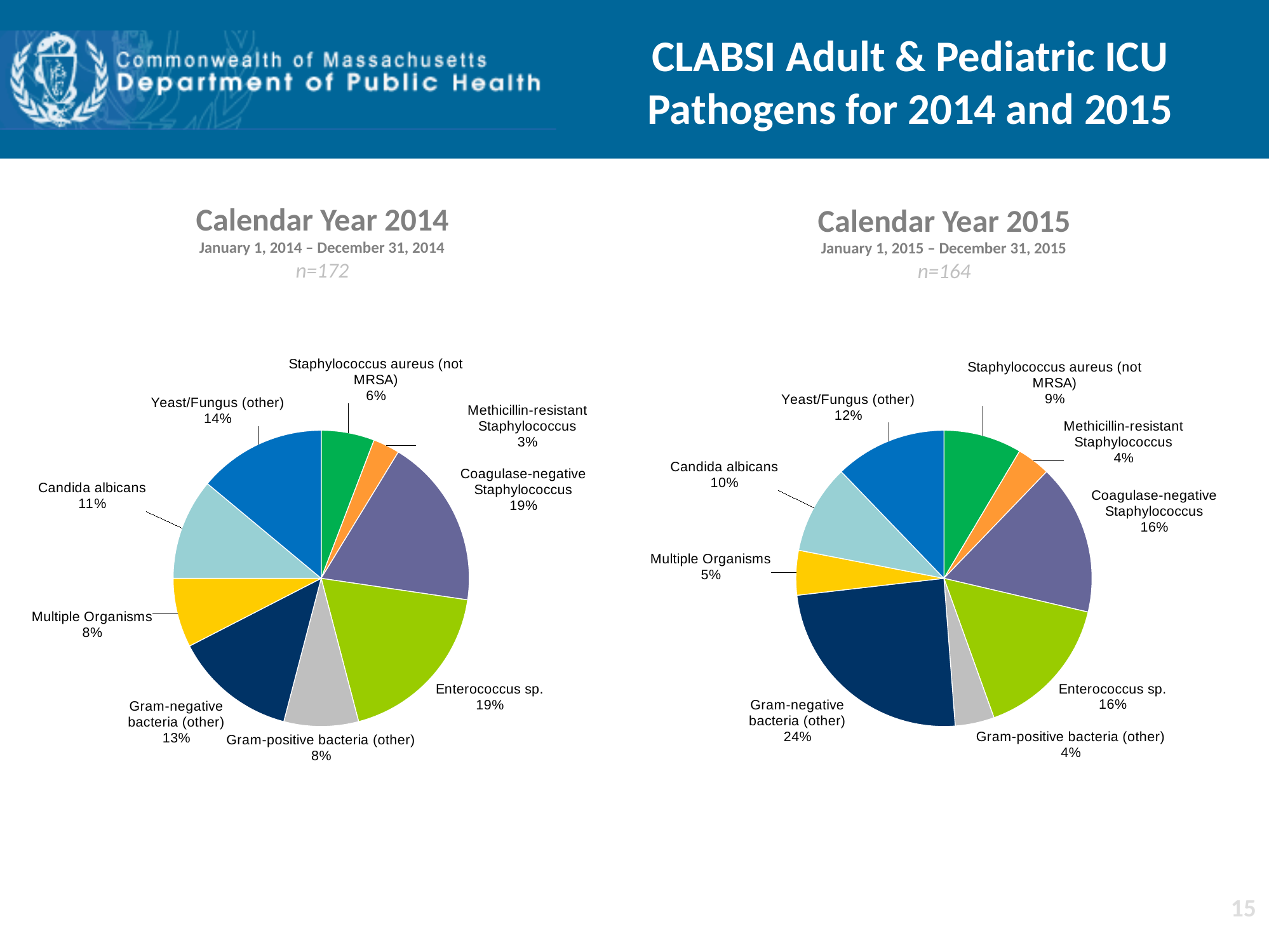
In the Calendar Year 2015 chart, what share is Gram-negative bacteria (other)? 24% How many pathogen categories are shown in the Calendar Year 2014 chart? 9 In the Calendar Year 2014 chart, what is the difference in percentage points between Gram-negative bacteria (other) and Gram-positive bacteria (other)? 5 In the Calendar Year 2015 chart, what is the difference in percentage points between Gram-negative bacteria (other) and Enterococcus sp.? 8 What is the n value shown under the Calendar Year 2015 chart title? n=164 In the Calendar Year 2014 chart, which is larger: Candida albicans or Multiple Organisms? Candida albicans What type of chart is used for Calendar Year 2015? Pie chart In the Calendar Year 2014 chart, which pathogen category has the smallest share? Methicillin-resistant Staphylococcus In the Calendar Year 2015 chart, which pathogen category has the largest share? Gram-negative bacteria (other) In the Calendar Year 2015 chart, what share is Multiple Organisms? 5% In the Calendar Year 2014 chart, what share is Coagulase-negative Staphylococcus? 19% In the Calendar Year 2014 chart, what share is Yeast/Fungus (other)? 14%